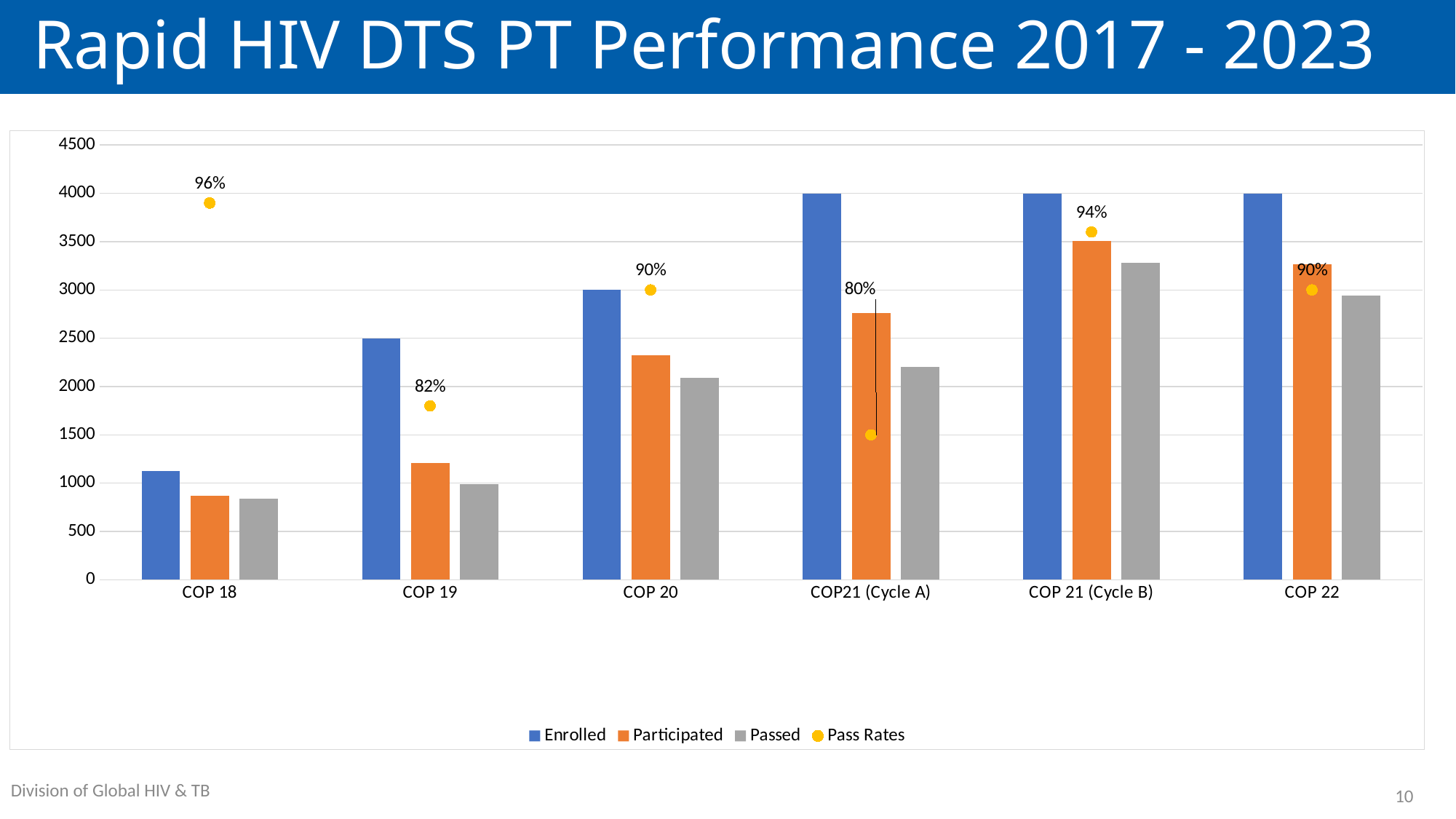
Is the Participated value for COP 21 (Cycle B) greater or less than 3000? greater How many categories are shown on the x axis? 6 What is the pass rate shown for COP21 (Cycle A)? 80% What is the difference between the pass rates for COP 18 and COP 19? 14% Which category has the highest pass rate? COP 18 Which category has the lowest pass rate? COP21 (Cycle A) What is the pass rate shown for COP 18? 96% What kind of chart is used for the Enrolled, Participated and Passed series? bar chart Is the pass rate for COP 20 higher or lower than the pass rate for COP 21 (Cycle B)? lower Is the Enrolled value for COP 18 greater or less than 1500? less How many series does the legend list? 4 What is the pass rate shown for COP 21 (Cycle B)? 94%